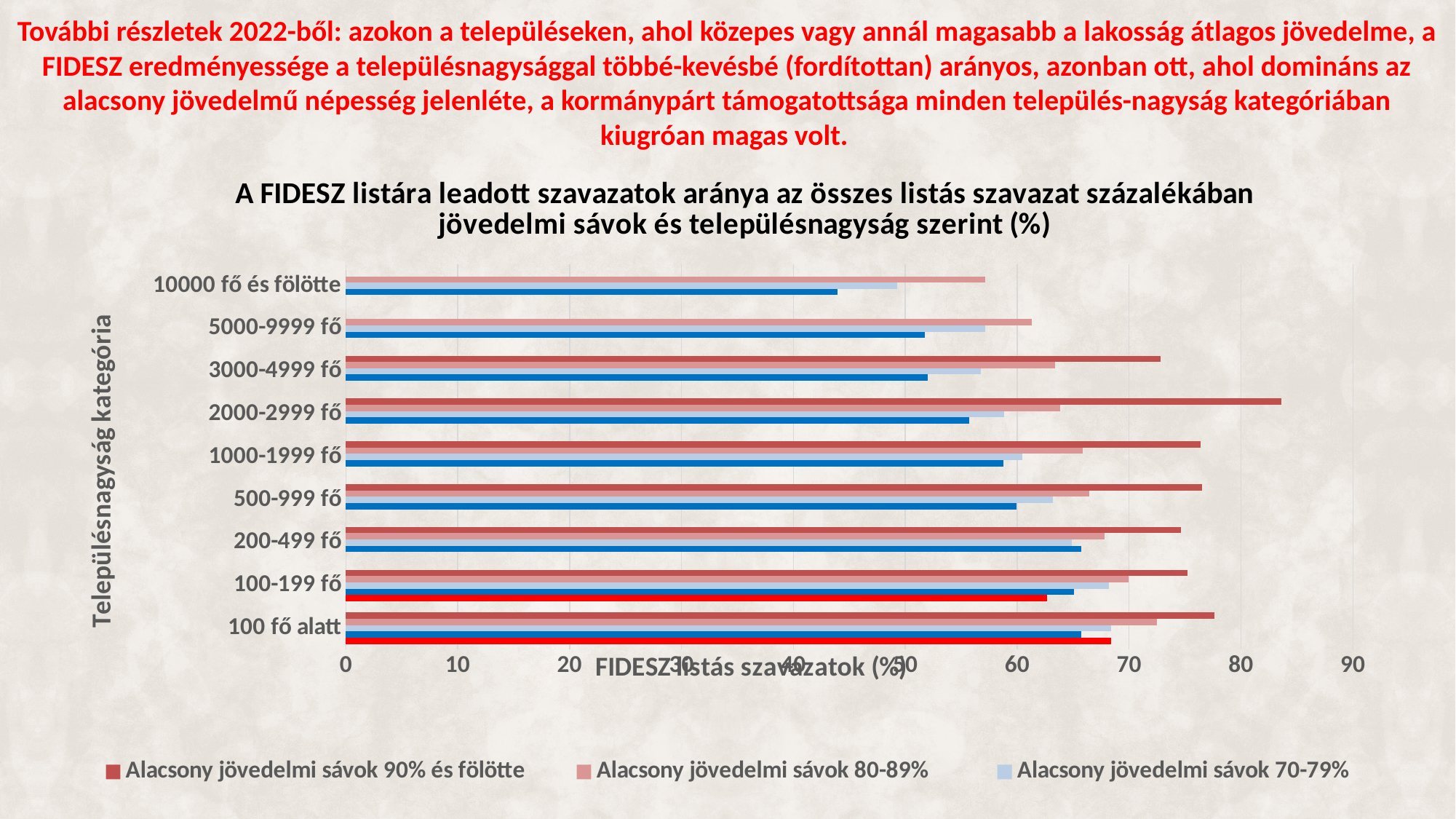
Which settlement-size category has the lowest value for the series 'Alacsony jövedelmi sávok 80-89%'? 10000 fő és fölötte Is the value for '5000-9999 fő' in the series 'Alacsony jövedelmi sávok 80-89%' greater or less than 70? less Which settlement-size category has the highest value for the series 'Alacsony jövedelmi sávok 90% és fölötte'? 2000-2999 fő What is the label of the vertical axis of the chart? Településnagyság kategória For the series 'Alacsony jövedelmi sávok 90% és fölötte', which is larger: the value for '2000-2999 fő' or for '3000-4999 fő'? 2000-2999 fő What kind of chart is shown on the slide? bar chart How many settlement-size categories are shown on the chart? 9 Is the value for '1000-1999 fő' in the series 'Alacsony jövedelmi sávok 80-89%' greater or less than 70? less Is the value for '100 fő alatt' in the series 'Alacsony jövedelmi sávok 90% és fölötte' greater or less than 70? greater What is the label of the horizontal axis of the chart? FIDESZ listás szavazatok (%)